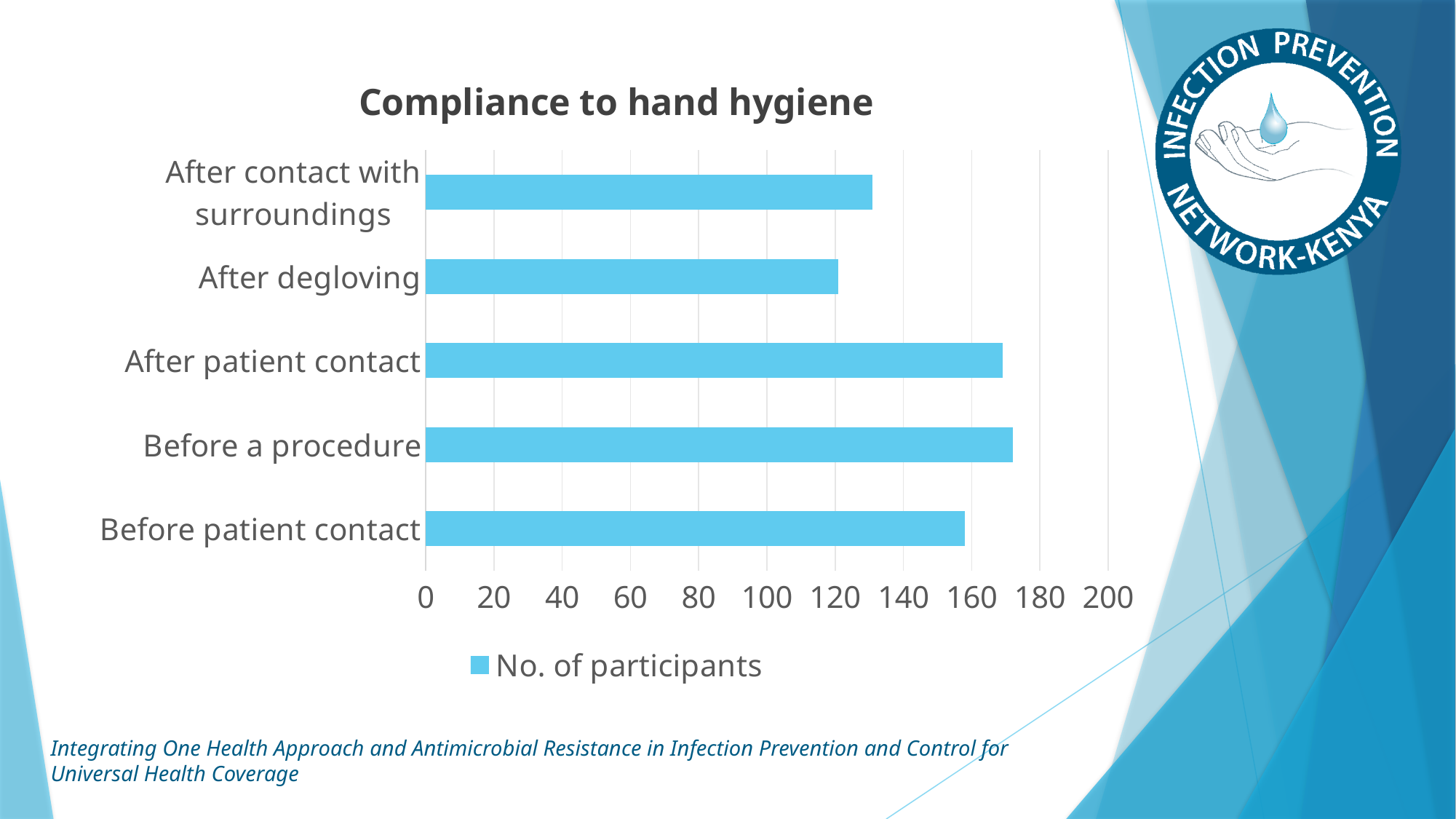
Is the value for After contact with surroundings greater or less than 140? less Which category has the lowest number of participants? After degloving Which is larger, the value for Before patient contact or the value for After degloving? Before patient contact Is the value for After degloving greater or less than 140? less Is the value for After patient contact greater or less than 160? greater Which is larger, the value for After contact with surroundings or the value for After degloving? After contact with surroundings What series name is shown in the legend? No. of participants What kind of chart is shown on the slide? Bar chart How many series does the legend list? 1 How many categories are plotted in the chart? 5 What is the title of the chart? Compliance to hand hygiene